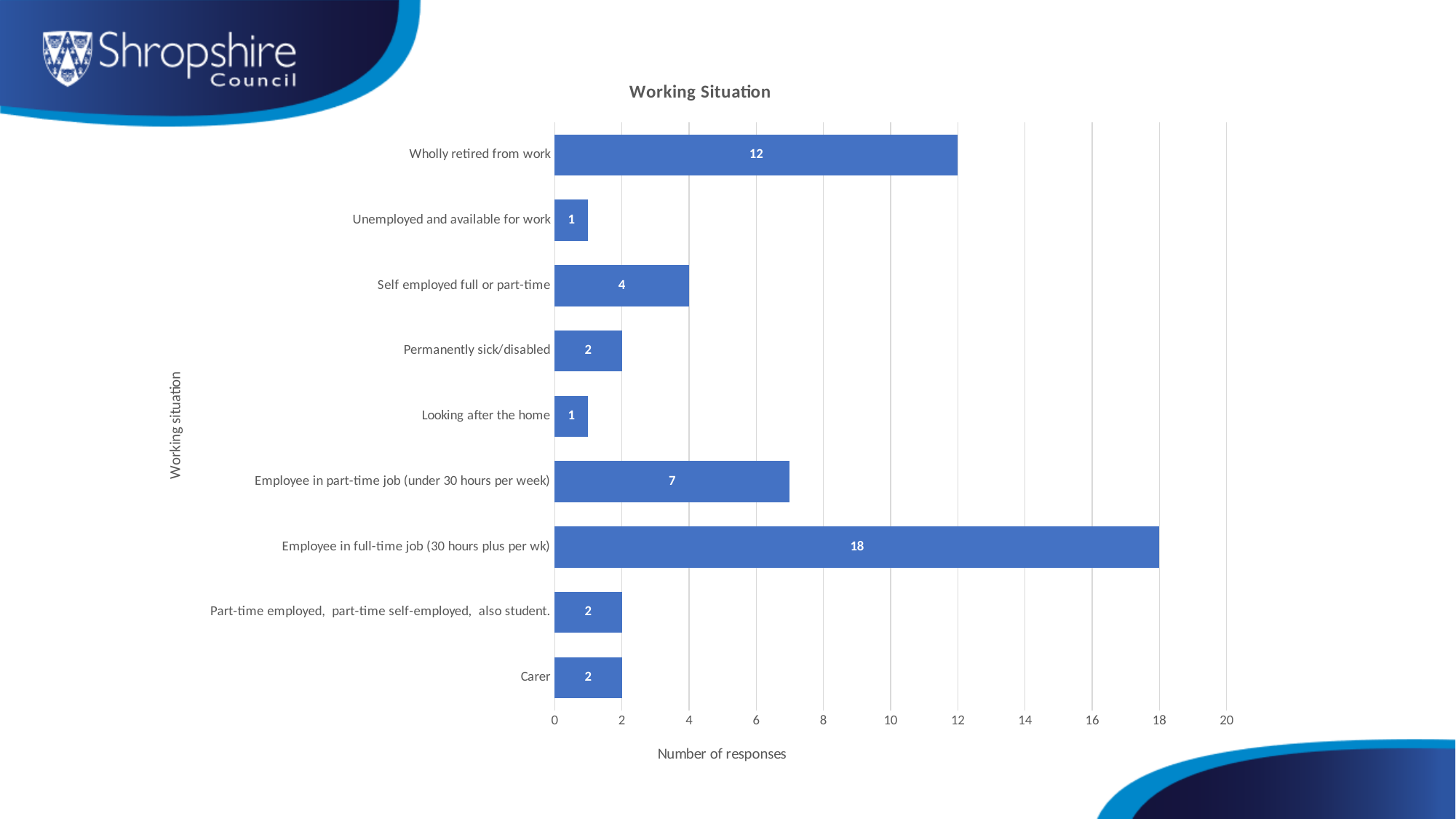
What is the number of responses for 'Employee in part-time job (under 30 hours per week)'? 7 What is the difference in responses between 'Employee in full-time job (30 hours plus per wk)' and 'Wholly retired from work'? 6 Is the value for 'Employee in full-time job (30 hours plus per wk)' greater or less than 16? greater How many working situation categories are shown in the chart? 9 What is the number of responses for 'Wholly retired from work'? 12 What type of chart is shown on the slide? Bar chart What is the number of responses for 'Carer'? 2 Which has more responses: 'Self employed full or part-time' or 'Permanently sick/disabled'? Self employed full or part-time Which working situation has the highest number of responses? Employee in full-time job (30 hours plus per wk) What is the number of responses for 'Self employed full or part-time'? 4 What is the label of the horizontal axis? Number of responses What is the title of the chart? Working Situation